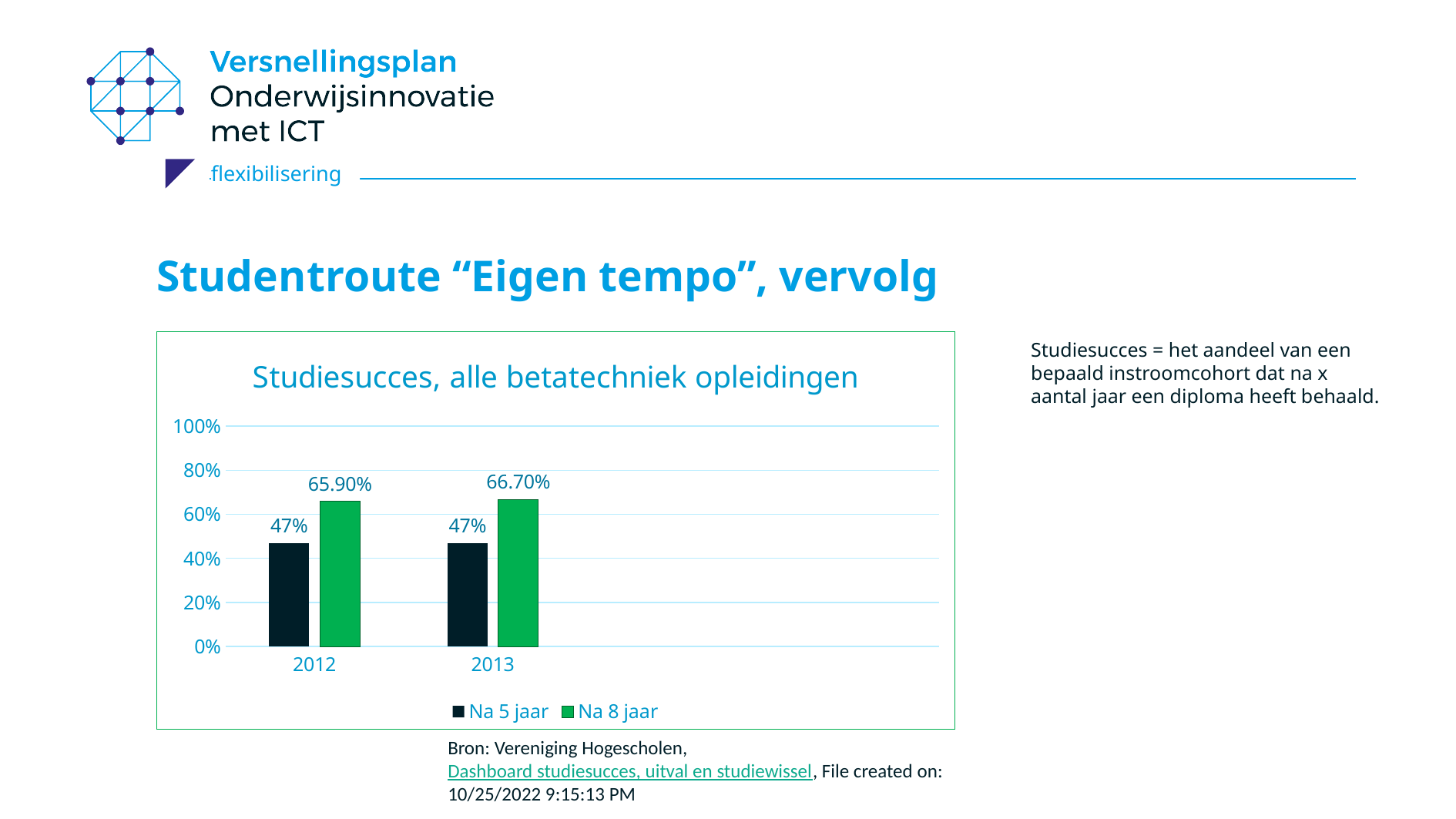
What is the value for "Na 8 jaar" in 2012? 65.90% What is the value for "Na 8 jaar" in 2013? 66.70% What is the value for "Na 5 jaar" in 2013? 47% What is the difference between the "Na 8 jaar" values for 2013 and 2012? 0.80% Which year has the highest value for "Na 8 jaar"? 2013 What is the title of the chart? Studiesucces, alle betatechniek opleidingen What kind of chart is shown? bar chart Is the value for "Na 5 jaar" in 2012 greater or less than 60%? less Which is larger in 2013: "Na 5 jaar" or "Na 8 jaar"? Na 8 jaar How many series does the legend list? 2 How many years are shown on the x axis? 2 What is the difference between "Na 8 jaar" and "Na 5 jaar" in 2012? 18.90%